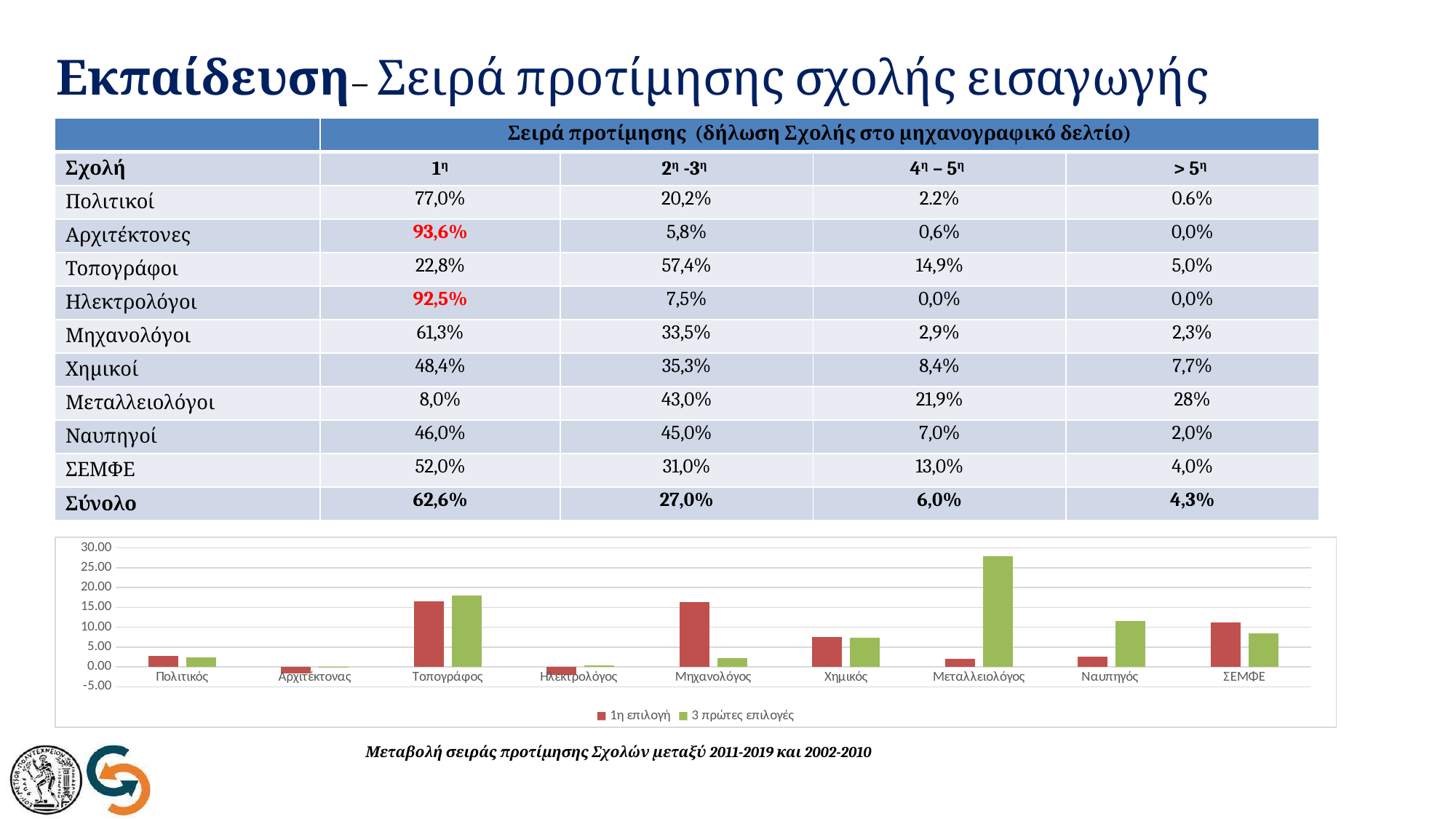
In the bar chart, for Μηχανολόγος, which series has the larger value: '1η επιλογή' or '3 πρώτες επιλογές'? 1η επιλογή In the bar chart, is the '3 πρώτες επιλογές' value for Ναυπηγός greater or less than 10.00? greater What colour are the bars for the '1η επιλογή' series in the bar chart? Red In the bar chart, is the '1η επιλογή' value for Τοπογράφος greater or less than 15.00? greater What kind of chart is shown at the bottom of the slide? Bar chart In the bar chart, is the '3 πρώτες επιλογές' value for Μεταλλειολόγος greater or less than 25.00? greater In the bar chart, which category has the highest value for the '3 πρώτες επιλογές' series? Μεταλλειολόγος How many categories (schools) are shown on the x axis of the bar chart? 9 How many series does the legend of the bar chart list? 2 In the bar chart, for Ναυπηγός, which series has the larger value: '1η επιλογή' or '3 πρώτες επιλογές'? 3 πρώτες επιλογές